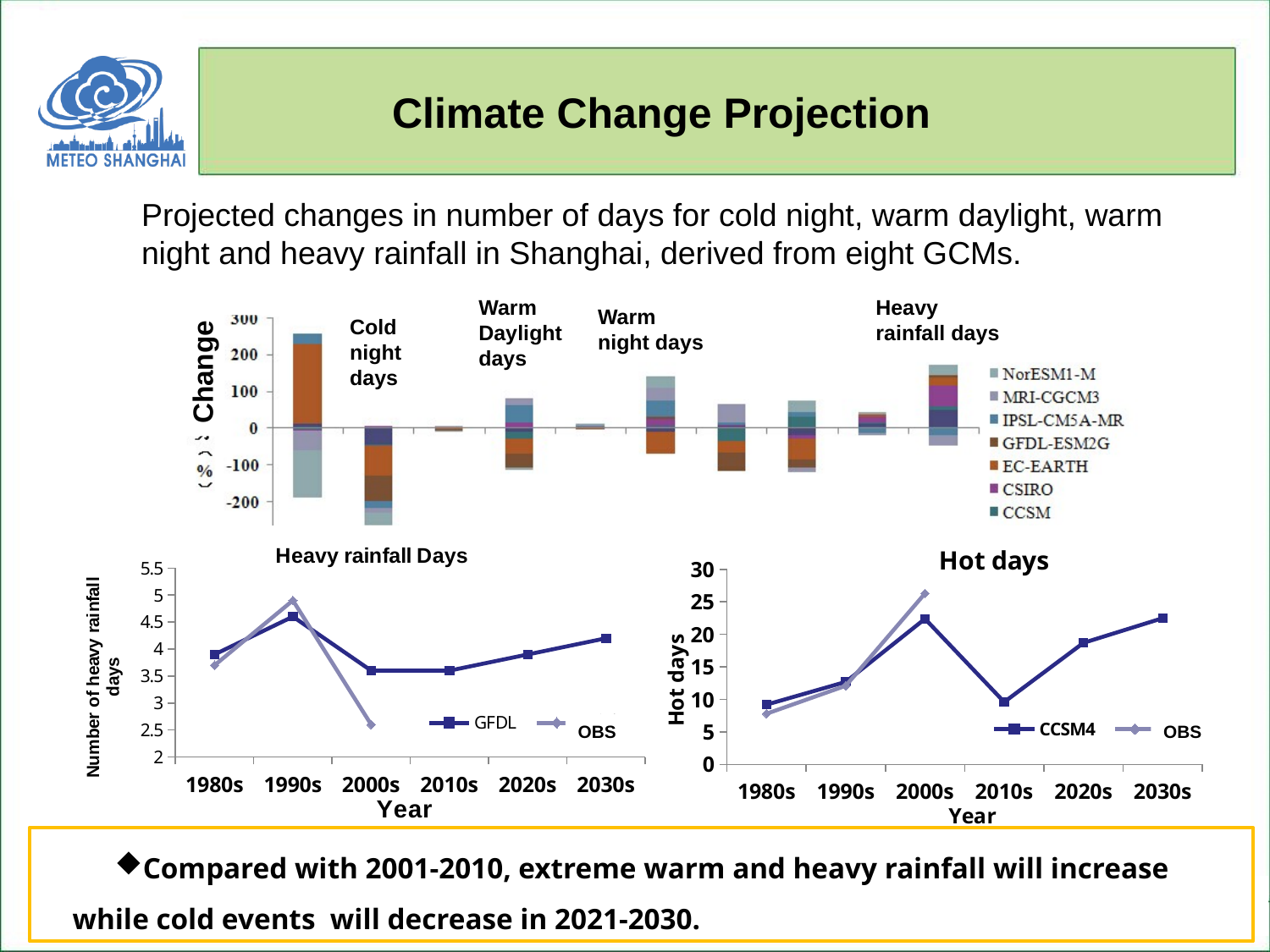
In the 'Heavy rainfall Days' chart, is the GFDL value for the 1990s greater or less than 4? greater In the 'Hot days' chart, is the CCSM4 value for the 2010s greater or less than 15? less What kind of chart is the 'Heavy rainfall Days' chart at the bottom left of the slide? Line chart In the 'Hot days' chart, which series has the larger value in the 2000s, CCSM4 or OBS? OBS In the 'Heavy rainfall Days' chart, is the OBS value for the 2000s greater or less than 3? less In the 'Hot days' chart, how many series does the legend list? 2 In the 'Heavy rainfall Days' chart, in which decade does the GFDL series reach its highest value? 1990s What is the y-axis title of the 'Heavy rainfall Days' chart? Number of heavy rainfall days In the 'Heavy rainfall Days' chart, how many decades are shown on the x axis? 6 In the 'Hot days' chart, does the CCSM4 series rise or fall from the 2010s to the 2030s? Rise What kind of chart is the top chart showing percentage change for cold night days, warm daylight days, warm night days and heavy rainfall days? Bar chart